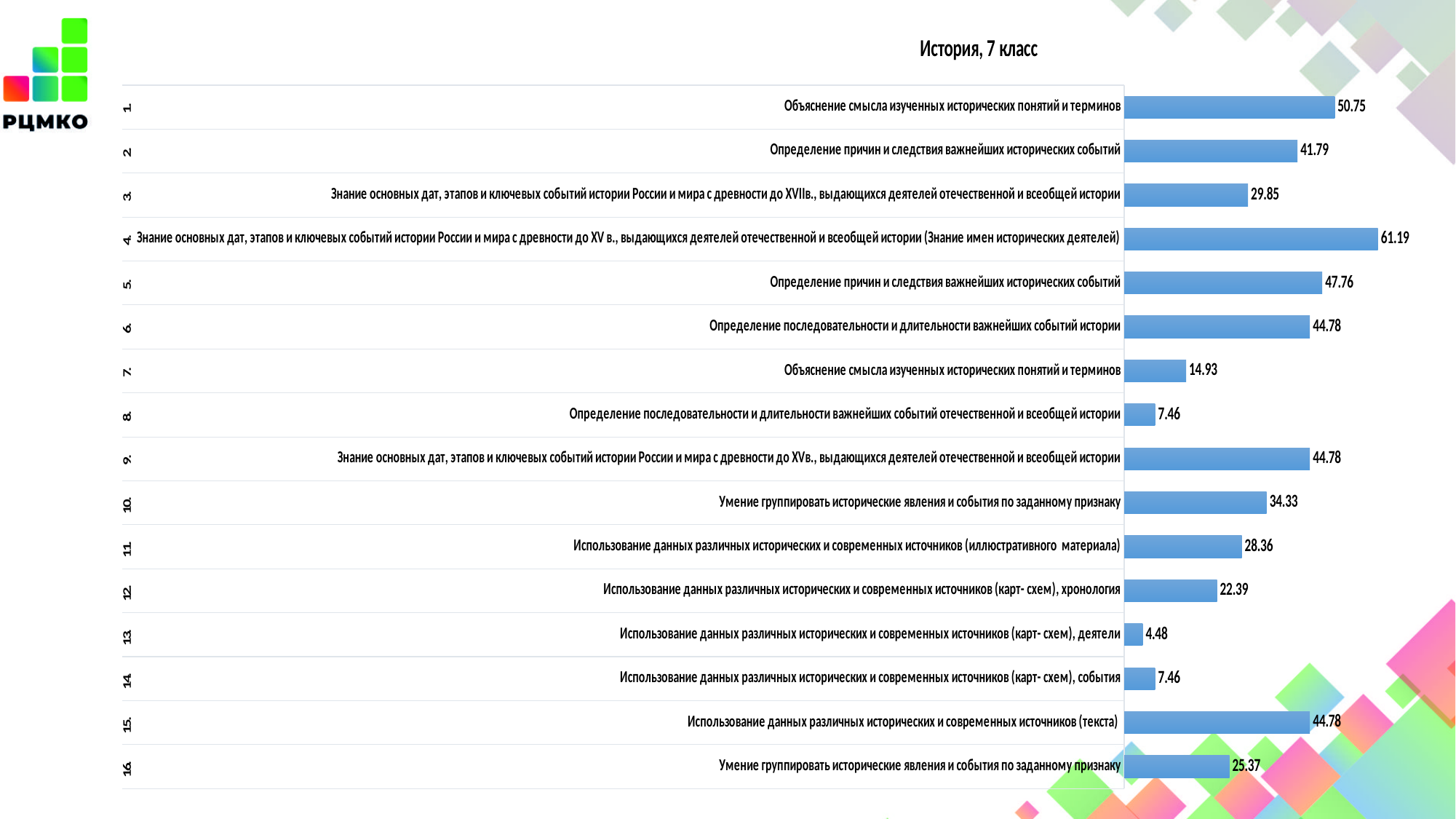
Which has the larger value: item 2 or item 5 (both labelled Определение причин и следствия важнейших исторических событий)? item 5 How many bars (categories) does the chart contain? 16 What is the difference between the values of item 12 and item 14? 14.93 What type of chart is shown on the slide? bar chart What is the difference between the values of item 1 and item 7 (both labelled Объяснение смысла изученных исторических понятий и терминов)? 35.82 What is the value for item 4 (Знание основных дат... до XV в. ... (Знание имен исторических деятелей))? 61.19 Which numbered item has the lowest value? 13 What is the value for item 10 (Умение группировать исторические явления и события по заданному признаку)? 34.33 What is the value for item 16 (Умение группировать исторические явления и события по заданному признаку)? 25.37 Which numbered item has the highest value? 4 What is the value for item 13 (Использование данных различных исторических и современных источников (карт- схем), деятели)? 4.48 What is the title of the chart? История, 7 класс